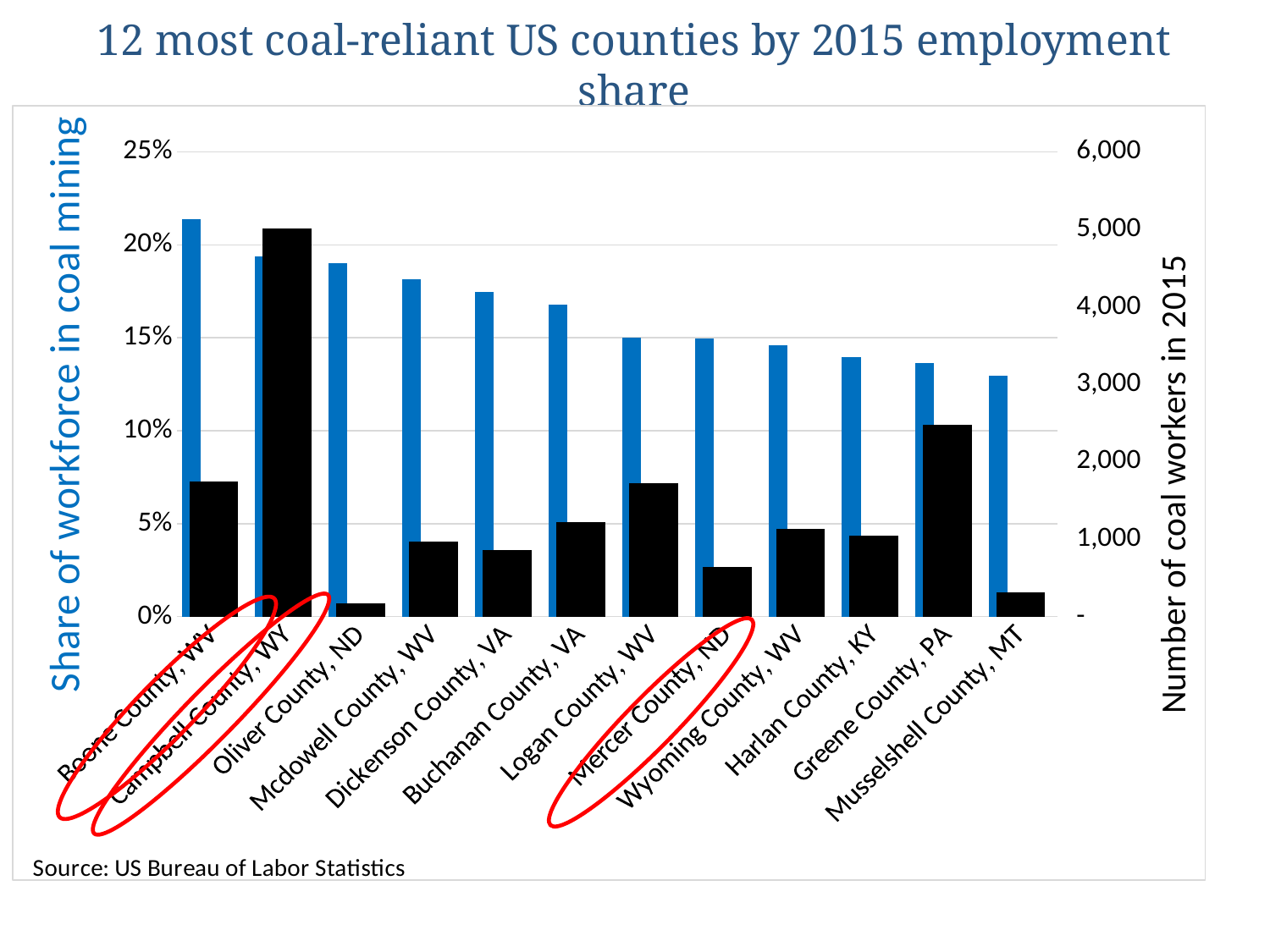
What kind of chart is shown on the slide? bar chart How many counties are shown on the x axis of the chart? 12 Do the share of workforce in coal mining values rise or fall from left to right across the counties? fall Which county has the highest number of coal workers in 2015? Campbell County, WY Which county has the highest share of workforce in coal mining? Boone County, WV Is the number of coal workers in 2015 for Greene County, PA greater or less than 2,000? greater Is the share of workforce in coal mining for Boone County, WV greater or less than 20%? greater What source is cited for the chart's data? US Bureau of Labor Statistics Which county has the lowest number of coal workers in 2015? Oliver County, ND Which county has the lowest share of workforce in coal mining? Musselshell County, MT Which county has more coal workers in 2015, Greene County, PA or Logan County, WV? Greene County, PA Is the number of coal workers in 2015 for Campbell County, WY greater or less than 4,000? greater